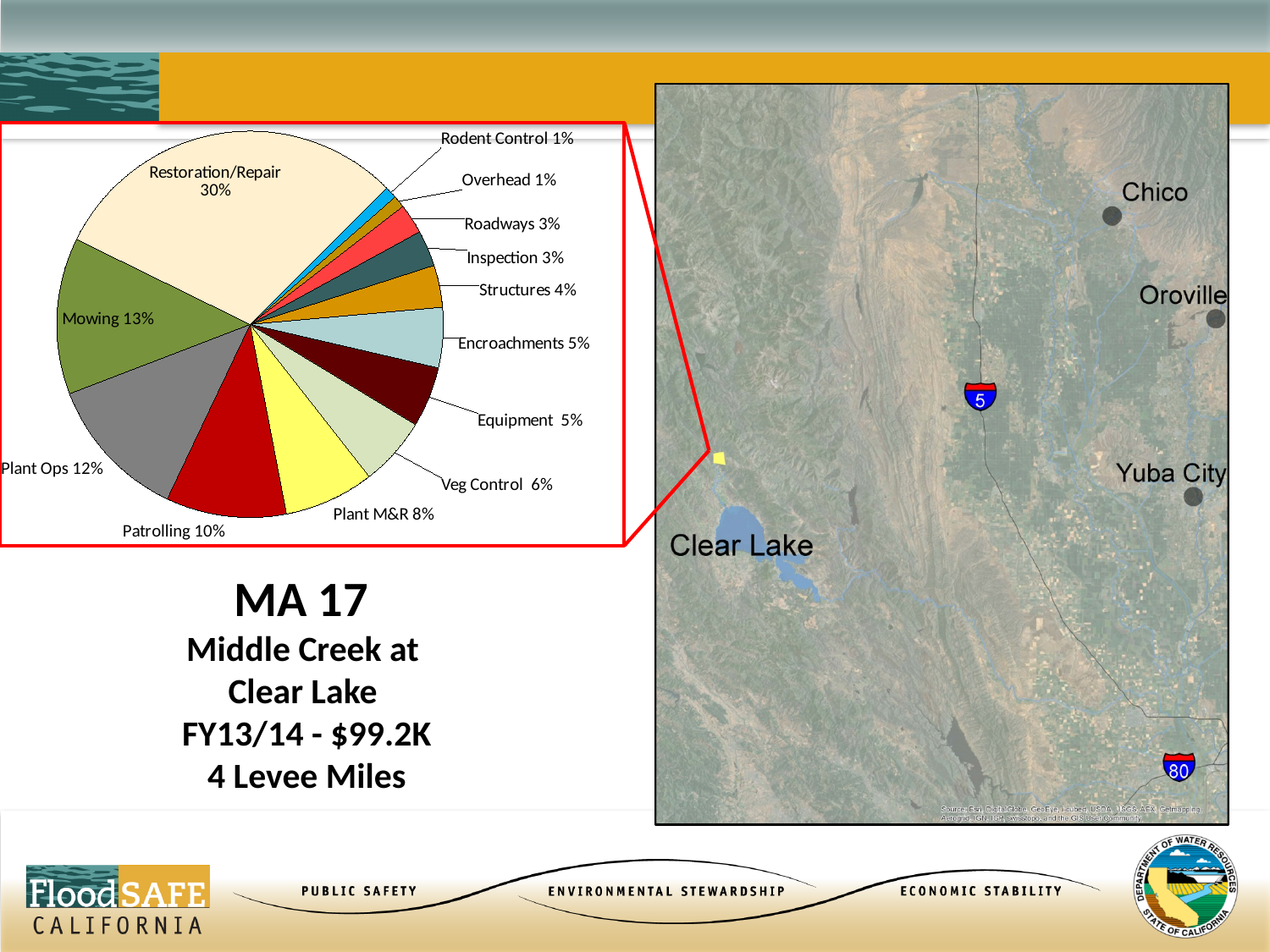
What percentage is shown for Inspection? 3% What is the difference in percentage points between Restoration/Repair and Mowing? 17 What percentage is shown for Encroachments? 5% What percentage is shown for Patrolling? 10% How many categories are shown in the pie chart? 13 Which category has a larger share, Plant M&R or Structures? Plant M&R What kind of chart is shown on the slide? pie chart Which category has the largest slice of the pie? Restoration/Repair What percentage is shown for Mowing? 13% What percentage is shown for Veg Control? 6% What share of the pie does Restoration/Repair account for? 30% What percentage is shown for Plant Ops? 12%